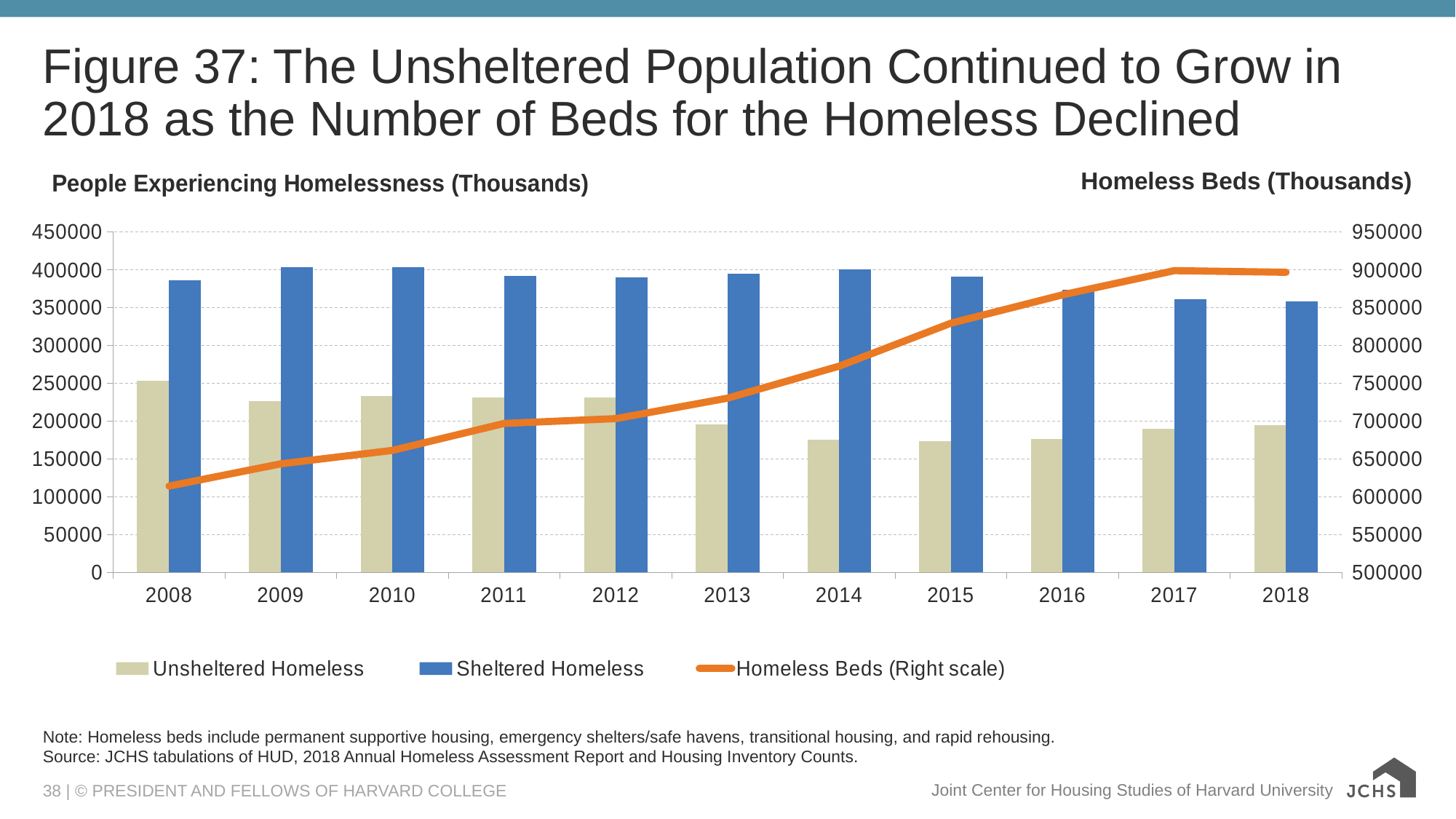
What kind of chart is shown on the slide? A combined bar and line chart Which series is plotted on the right scale according to the legend? Homeless Beds Which year has the lowest Homeless Beds value? 2008 Is the Unsheltered Homeless value for 2014 greater or less than 200000? less Is the Sheltered Homeless value for 2018 greater or less than 400000? less Which is larger, the Sheltered Homeless value for 2010 or for 2018? 2010 How many years are shown on the x axis? 11 How many series does the legend list? 3 Does the Homeless Beds line generally rise or fall from 2008 to 2017? rise Which year has the highest Unsheltered Homeless value? 2008 Is the Homeless Beds value for 2017 greater or less than 850000 on the right scale? greater Which is larger, the Unsheltered Homeless value for 2008 or for 2018? 2008